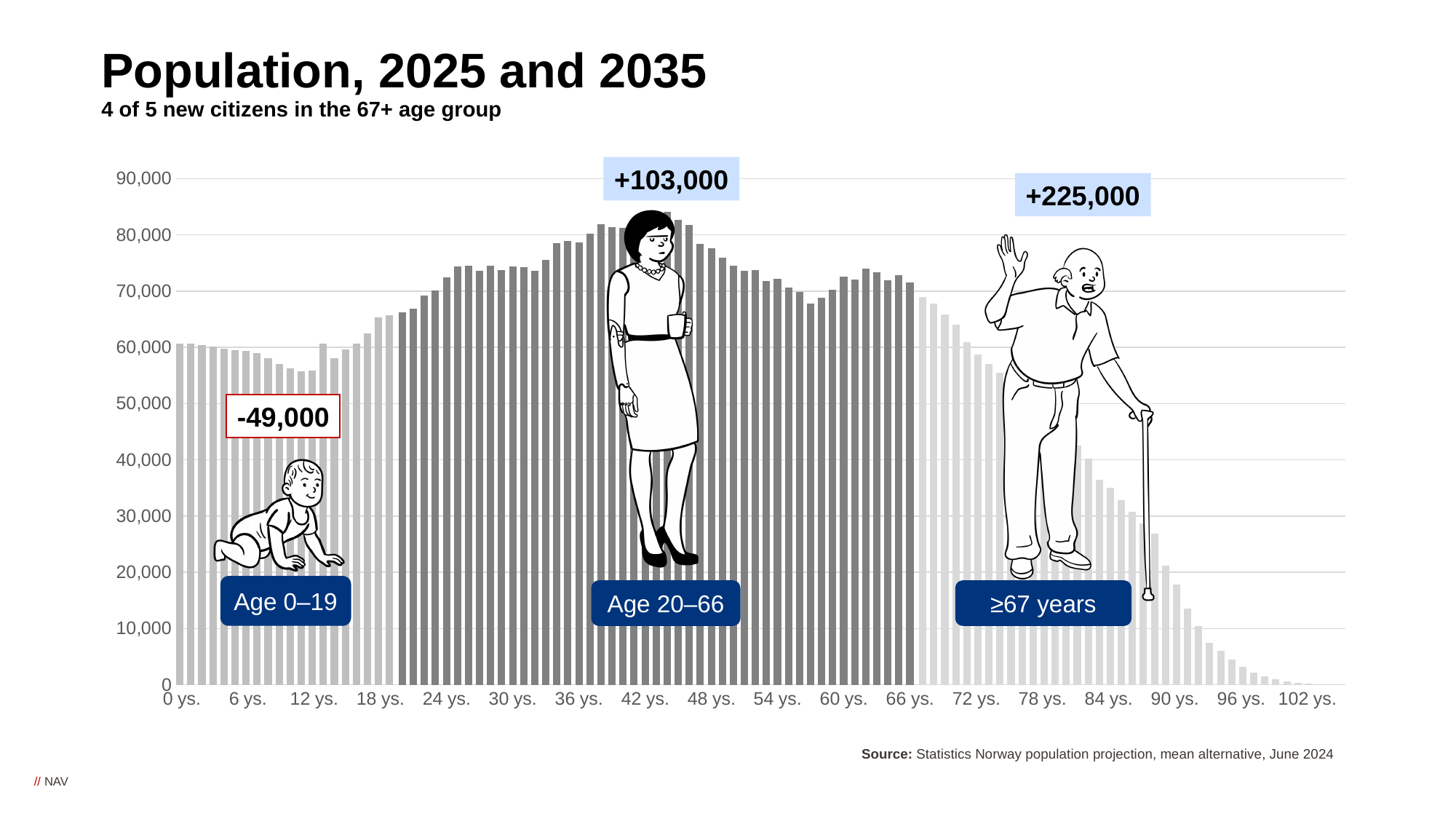
Which is larger, the change for the ≥67 years group or the change for the Age 20–66 group? ≥67 years Is the value for 90 ys. greater or less than 20,000? less What is the change shown for the Age 0–19 group? -49,000 What is the change shown for the Age 20–66 group? +103,000 Is the value for 42 ys. greater or less than 80,000? greater What kind of chart is shown on the slide? bar chart How many age groups are labelled on the chart? 3 Which age group has the largest change shown? ≥67 years Which age group has the smallest change shown? Age 0–19 What is the change shown for the ≥67 years group? +225,000 What is the difference between the change for the ≥67 years group and the change for the Age 20–66 group? 122,000 Do the values rise or fall along the x axis from 66 ys. to 102 ys.? fall